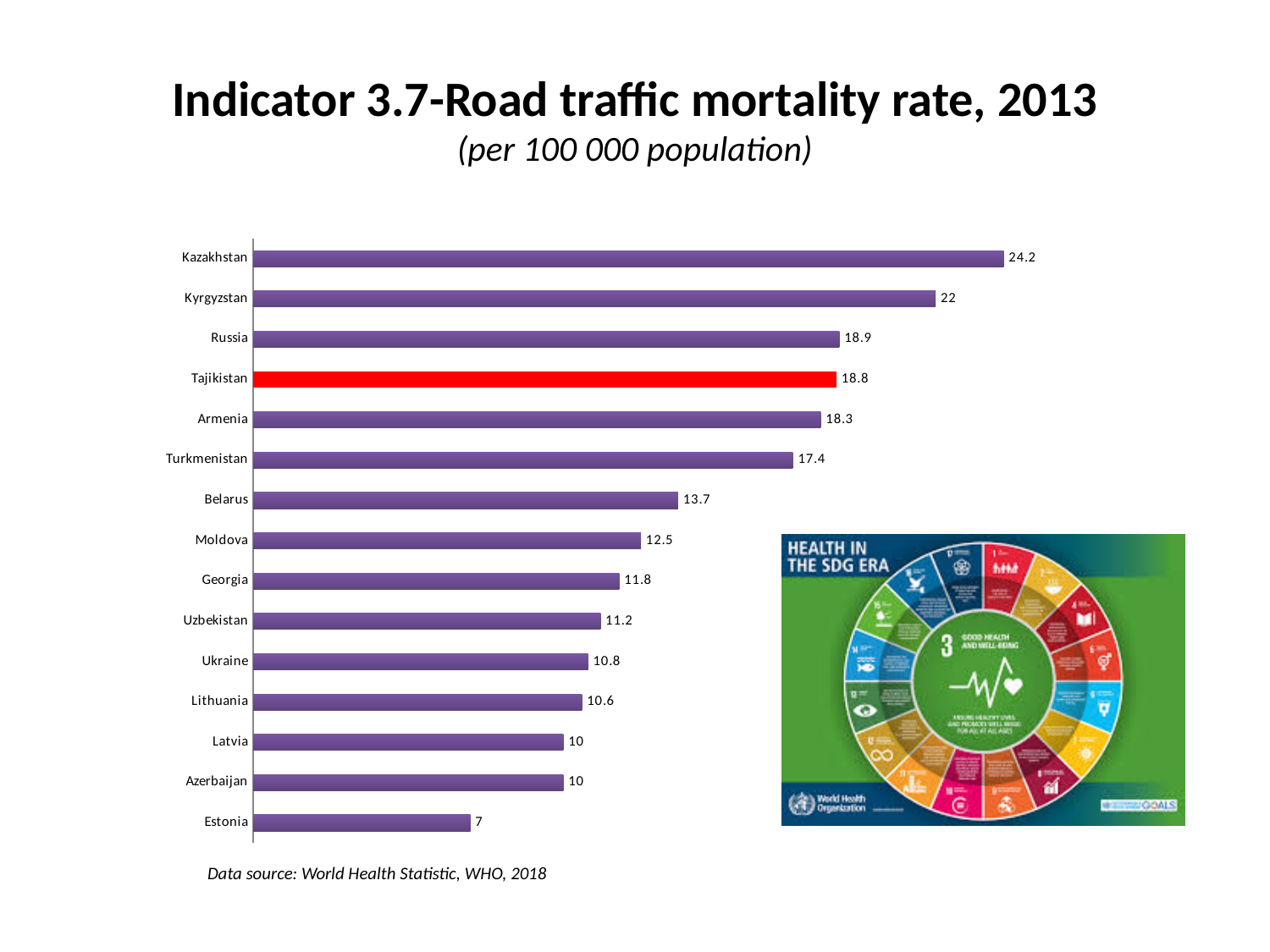
What is the difference between the values for Kazakhstan and Kyrgyzstan? 2.2 Which country has the highest road traffic mortality rate? Kazakhstan What is the difference between the values for Turkmenistan and Estonia? 10.4 How many countries are shown in the chart? 15 What kind of chart is shown on the slide? Bar chart What is the road traffic mortality rate for Tajikistan? 18.8 Which has a higher value, Armenia or Ukraine? Armenia Which has a higher road traffic mortality rate, Moldova or Georgia? Moldova What is the road traffic mortality rate for Belarus? 13.7 What is the value shown for Uzbekistan? 11.2 Which country has the lowest road traffic mortality rate? Estonia Which country's bar is highlighted in red? Tajikistan